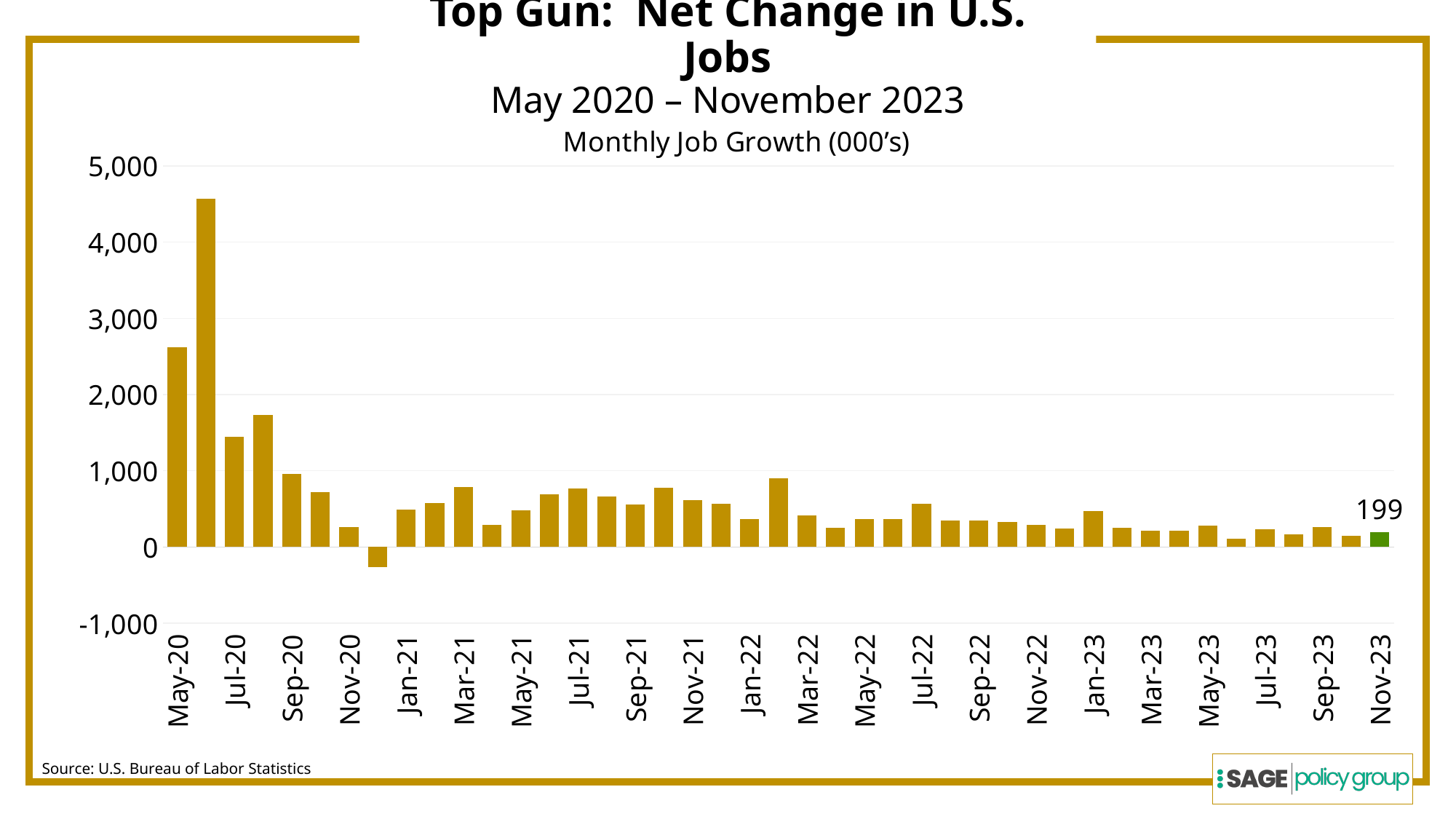
Is the value for Nov-20 greater or less than 500? less Which has the larger value, May-20 or Jul-20? May-20 How many bars on the chart show a negative value? 1 What kind of chart is shown on the slide? bar chart Is the value for Jul-20 greater or less than 1,000? greater Which has the larger value, Jul-21 or Jul-23? Jul-21 What colour is the bar for Nov-23? green What is the value for Nov-23? 199 Is the value for May-20 greater or less than 2,000? greater What is the title of the chart? Monthly Job Growth (000’s) Overall, do the values rise or fall from May-20 to Nov-23? fall